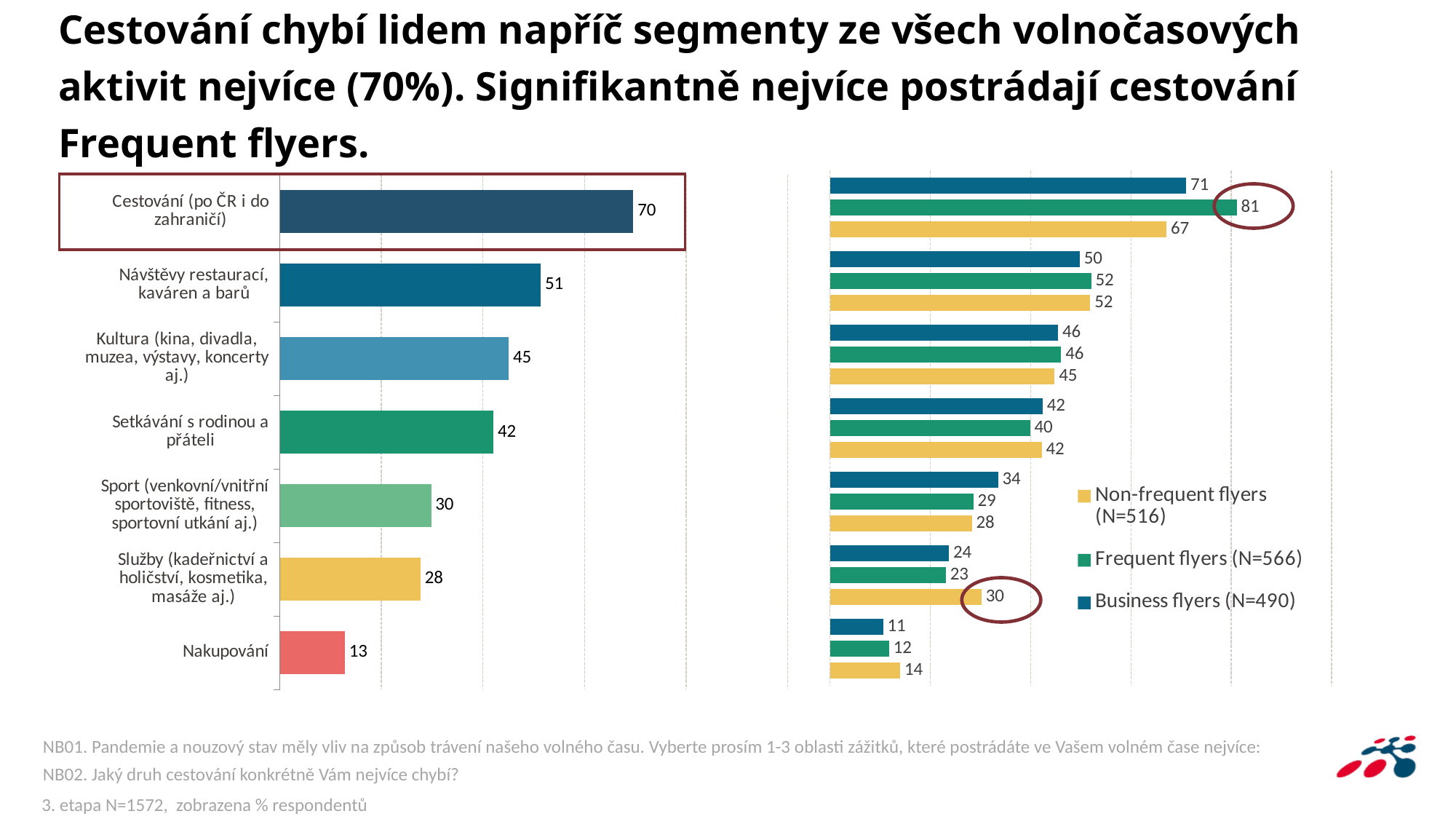
On the right chart, in the top group of bars, which is larger: Business flyers or Non-frequent flyers? Business flyers On the right chart, what is the value for Frequent flyers in the top group of bars? 81 On the left chart, which category has the highest value? Cestování (po ČR i do zahraničí) What kind of chart is the left chart? bar chart On the right chart, what is the value for Non-frequent flyers in the bottom group of bars? 14 On the left chart, how many categories are shown? 7 On the left chart, what is the value for Setkávání s rodinou a přáteli? 42 On the left chart, what is the value for Nakupování? 13 On the right chart, what sample size does the legend give for Business flyers? N=490 On the right chart, how many series does the legend list? 3 On the left chart, what is the difference between Návštěvy restaurací, kaváren a barů and Kultura (kina, divadla, muzea, výstavy, koncerty aj.)? 6 On the left chart, which category has the lowest value? Nakupování